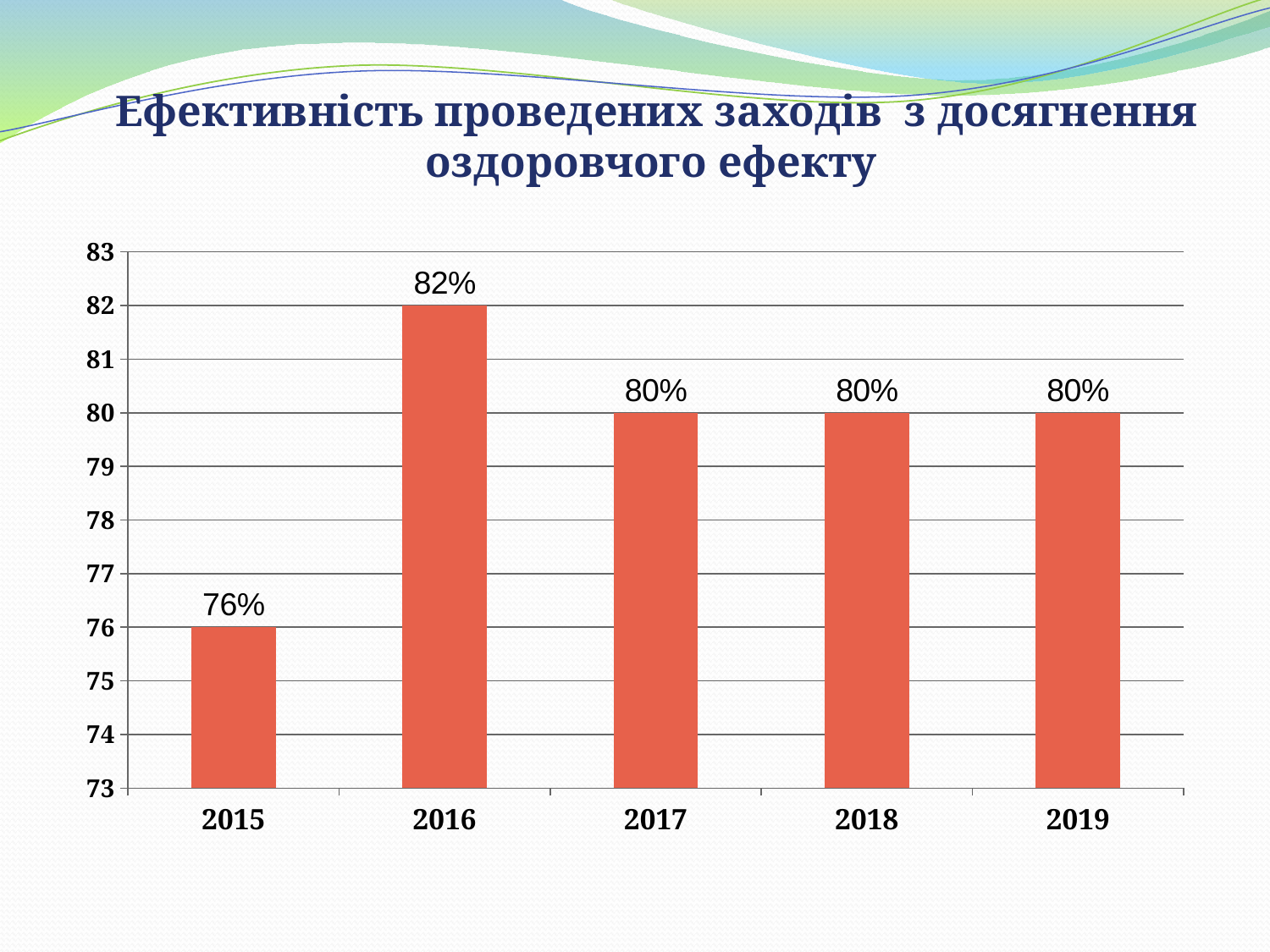
What is the value for 2018? 80% What is the difference between the values for 2016 and 2015? 6% Which is larger, the value for 2015 or the value for 2019? 2019 Which year has the highest value? 2016 Which year has the lowest value? 2015 How many years are shown on the x axis? 5 What kind of chart is shown on the slide? bar chart Is the value for 2015 greater or less than 78? less What is the title of the chart on the slide? Ефективність проведених заходів з досягнення оздоровчого ефекту What is the difference between the values for 2016 and 2017? 2% What is the value for 2016? 82% What is the value for 2015? 76%